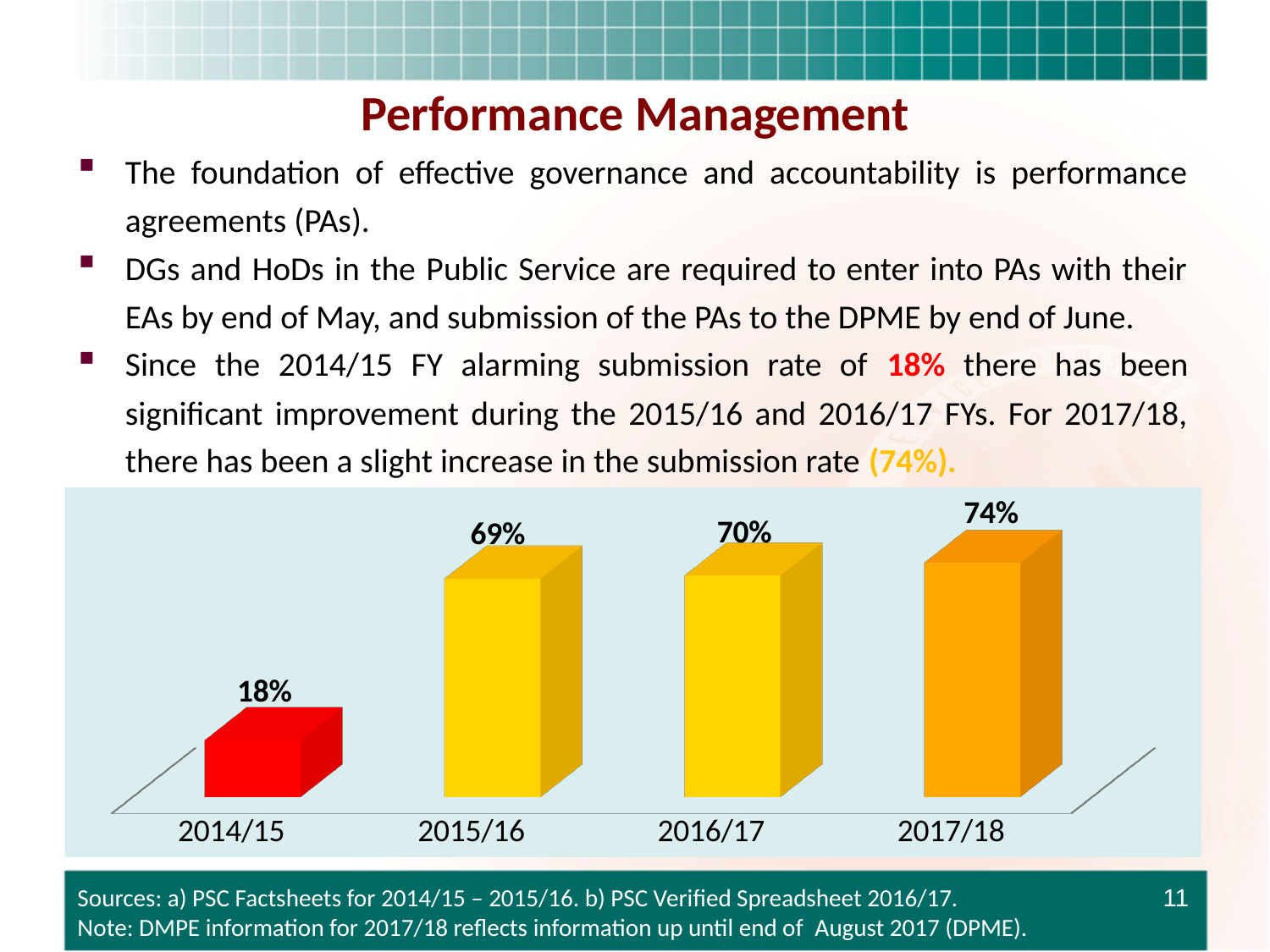
What kind of chart is shown on the slide? bar chart How many years are shown in the chart? 4 What is the value for 2014/15? 18% What is the difference between the values for 2016/17 and 2015/16? 1% Which is larger, the value for 2015/16 or the value for 2017/18? 2017/18 What is the value for 2017/18? 74% Which year has the highest value? 2017/18 What is the value for 2015/16? 69% Which year has the lowest value? 2014/15 Do the values rise or fall from 2014/15 to 2017/18? rise What is the value for 2016/17? 70% What is the difference between the values for 2017/18 and 2014/15? 56%